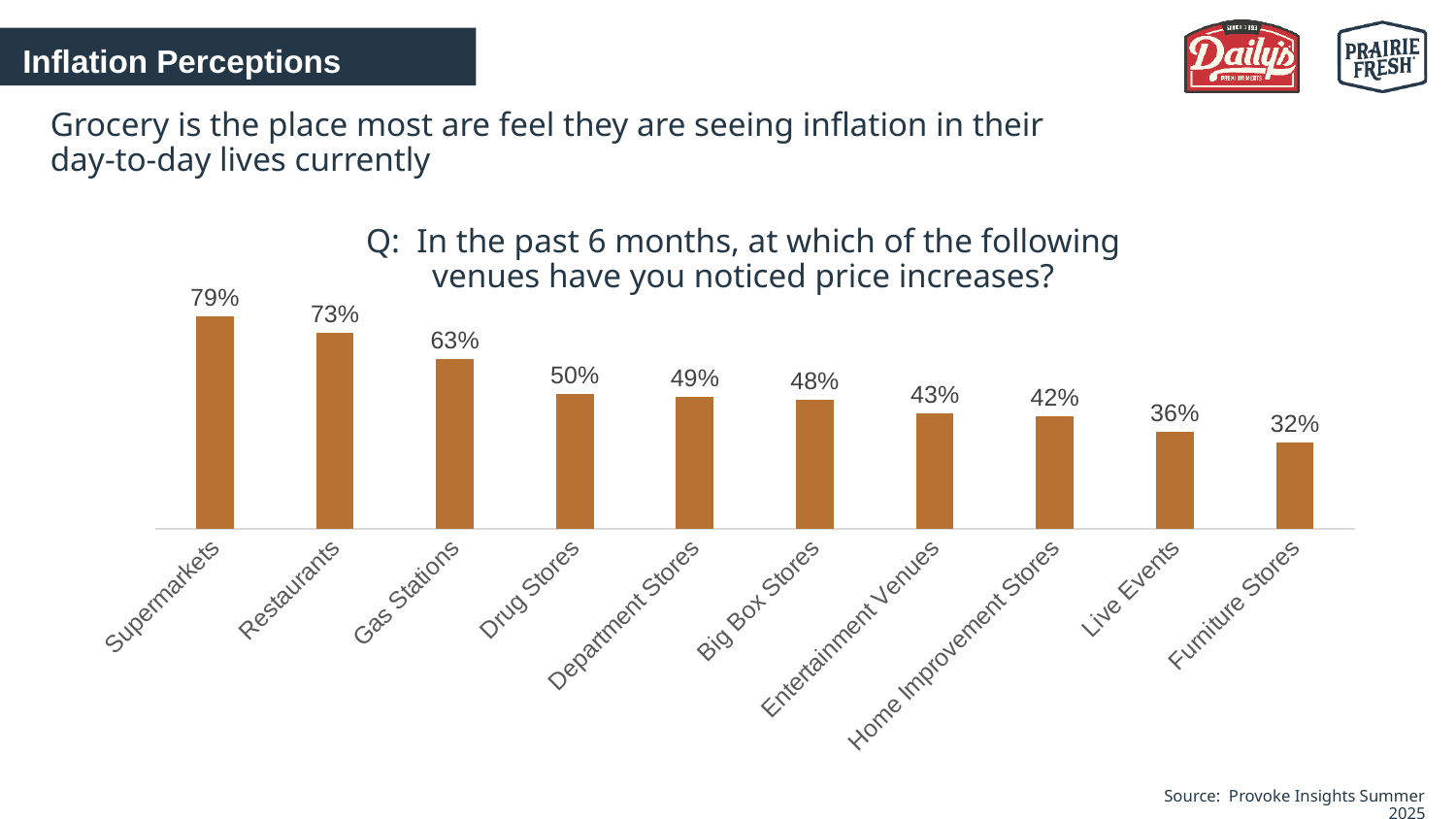
What kind of chart is shown on the slide? Bar chart Which venue has the highest percentage of respondents noticing price increases? Supermarkets What is the value shown for Gas Stations? 63% How many venues are shown in the chart? 10 What is the difference in percentage points between Drug Stores and Furniture Stores? 18 Which has a higher value, Entertainment Venues or Live Events? Entertainment Venues What question is the chart titled with? Q: In the past 6 months, at which of the following venues have you noticed price increases? Which venue has the lowest percentage of respondents noticing price increases? Furniture Stores What is the difference in percentage points between Supermarkets and Restaurants? 6 What percentage of respondents noticed price increases at Supermarkets? 79% What percentage is shown for Home Improvement Stores? 42% Do the values rise or fall moving from left to right across the chart? Fall